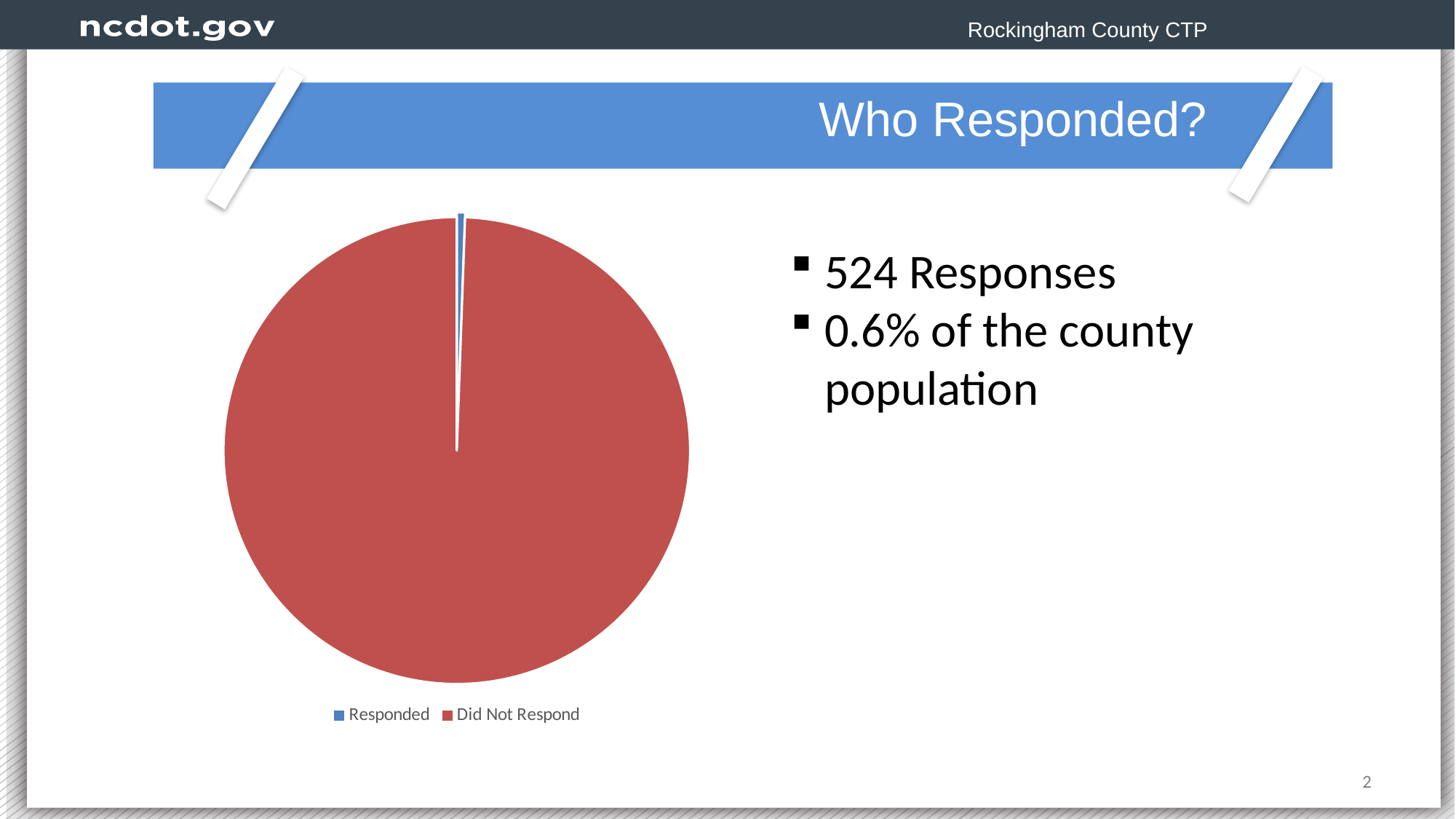
Which category takes up the largest share of the pie chart? Did Not Respond How many entries does the legend of the pie chart list? 2 What colour is the Responded slice in the pie chart? blue What are the two legend entries of the pie chart? Responded, Did Not Respond How many slices does the pie chart have? 2 What kind of chart is shown on the slide? pie chart Is the share of the pie chart for Responded greater or less than 50%? less Which category takes up the smallest share of the pie chart? Responded Which slice is larger in the pie chart, Responded or Did Not Respond? Did Not Respond Is the share of the pie chart for Did Not Respond greater or less than 50%? greater